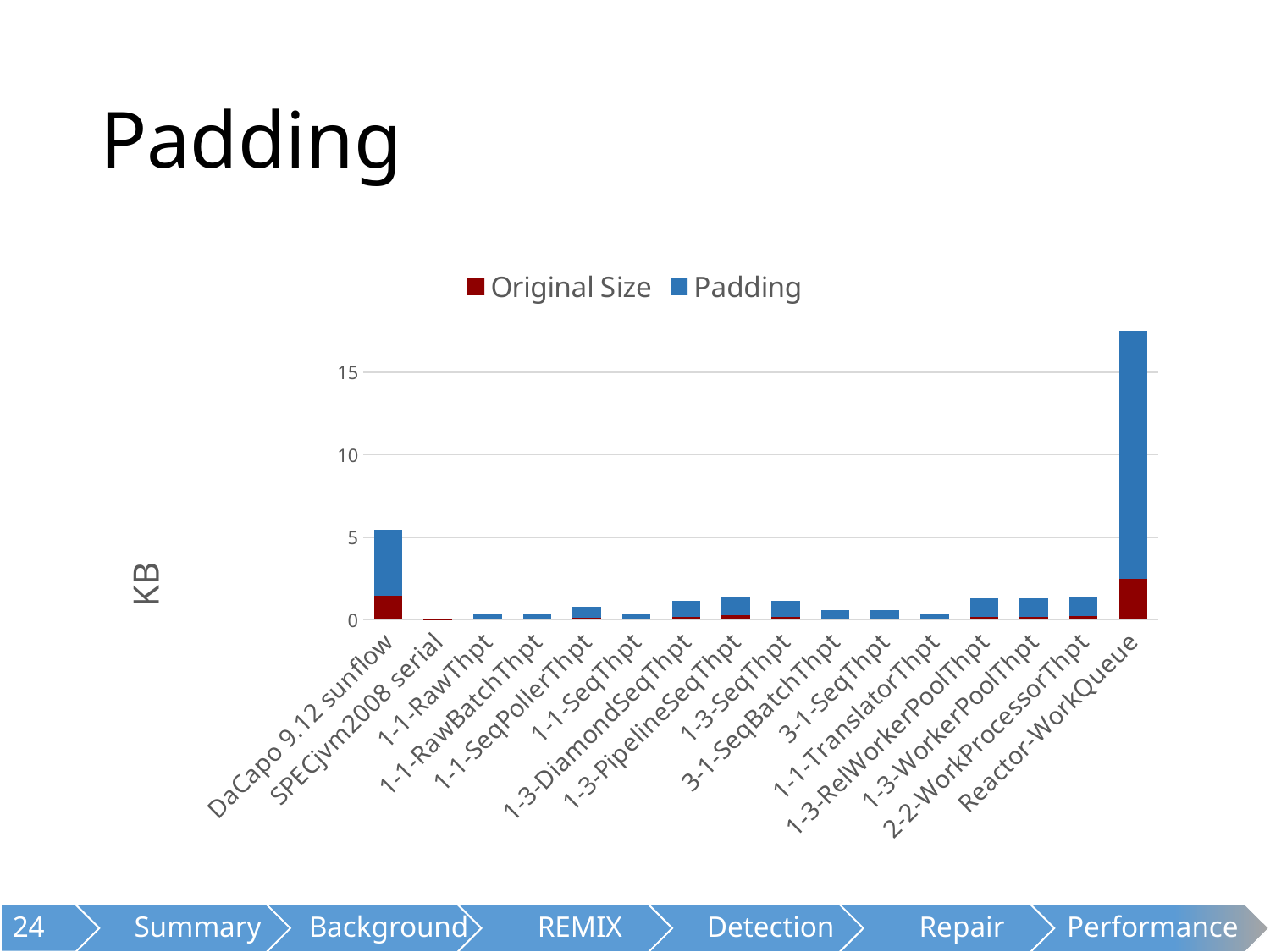
What is the label on the y axis? KB Which category has the smallest stacked bar? SPECjvm2008 serial How many categories are shown on the x axis? 16 Is the total value for Reactor-WorkQueue greater or less than 15? greater Which category has the tallest stacked bar? Reactor-WorkQueue How many series does the legend list? 2 Is the total value for 1-1-RawThpt greater or less than 5? less What kind of chart is shown on the slide? bar chart Which has the larger stacked bar, DaCapo 9.12 sunflow or 1-1-RawThpt? DaCapo 9.12 sunflow Is the total value for DaCapo 9.12 sunflow greater or less than 10? less Which series is shown in blue in the legend? Padding Which has the larger stacked bar, Reactor-WorkQueue or DaCapo 9.12 sunflow? Reactor-WorkQueue